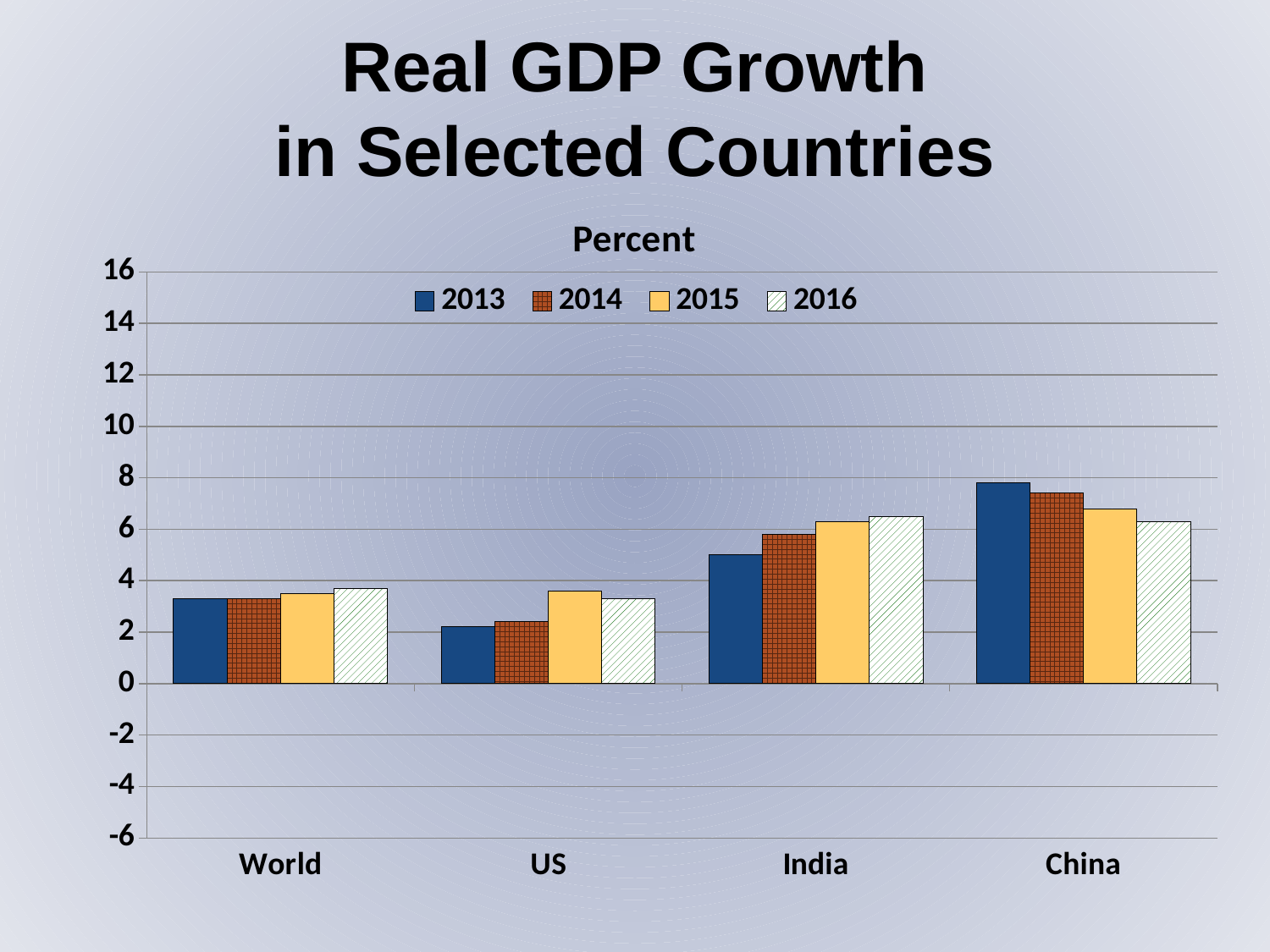
Which country or region has the lowest real GDP growth in 2013? US Is the 2013 value for China greater or less than 6? greater What kind of chart is shown on the slide? bar chart Which country or region has the highest real GDP growth in 2013? China Which is larger, the 2013 value for the US or the 2013 value for India? India For India, which year has the lowest real GDP growth? 2013 Is the 2013 value for the US greater or less than 4? less Is the 2016 value for India greater or less than 6? greater Do China's values rise or fall from 2013 to 2016? fall How many series does the legend list? 4 What unit label is shown above the chart? Percent How many countries/regions are shown on the x axis? 4